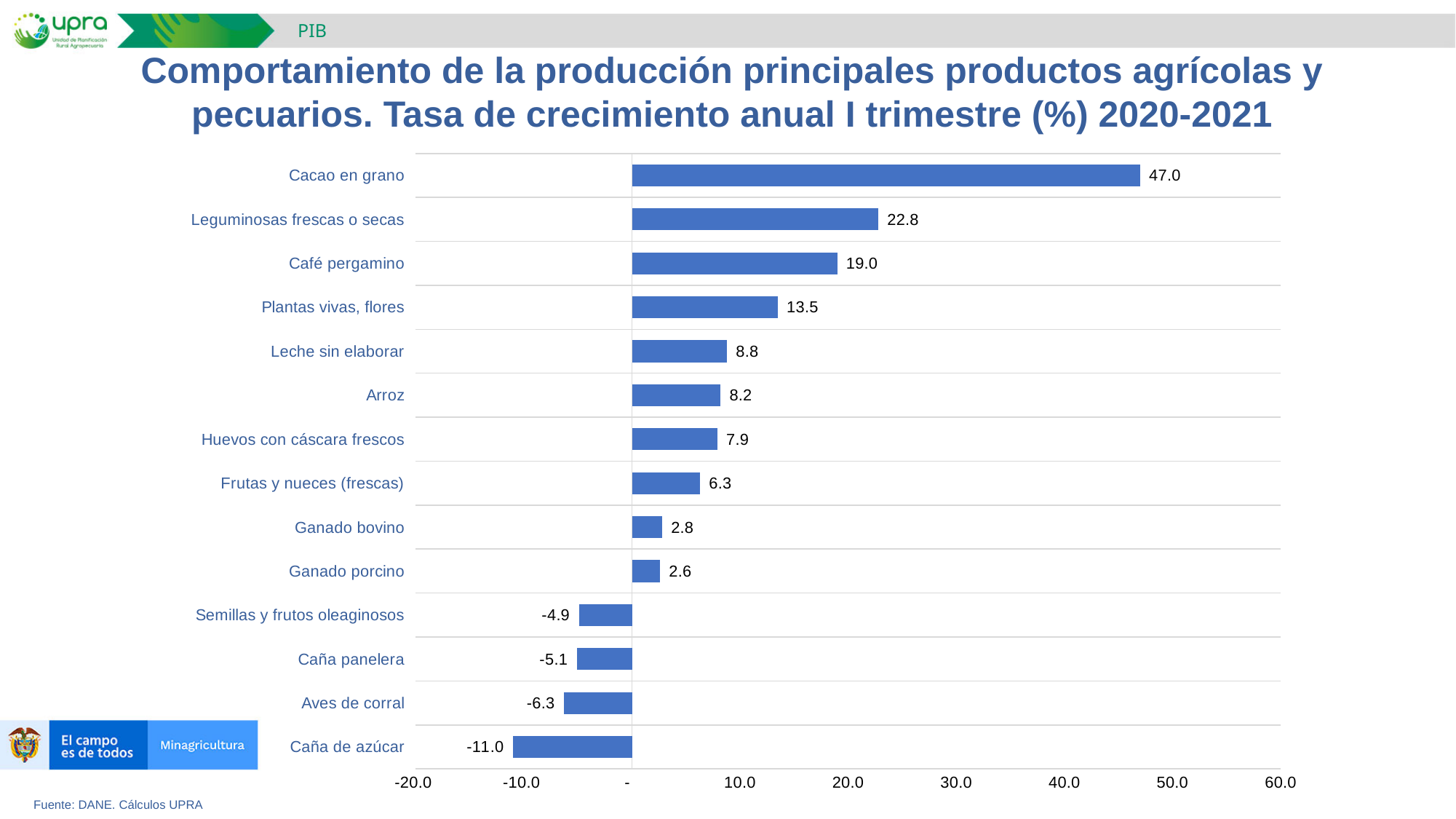
What is the value for Caña de azúcar? -11.0 How many categories are shown in the chart? 14 Which category has the lowest value? Caña de azúcar Which is larger, the value for Plantas vivas, flores or the value for Arroz? Plantas vivas, flores What is the difference between the values for Leguminosas frescas o secas and Café pergamino? 3.8 Which category has the highest value? Cacao en grano What is the value for Leche sin elaborar? 8.8 Is the value for Cacao en grano greater or less than 40.0? greater How many categories have negative values? 4 What is the source cited below the chart? Fuente: DANE. Cálculos UPRA What is the value for Cacao en grano? 47.0 What kind of chart is shown on the slide? bar chart